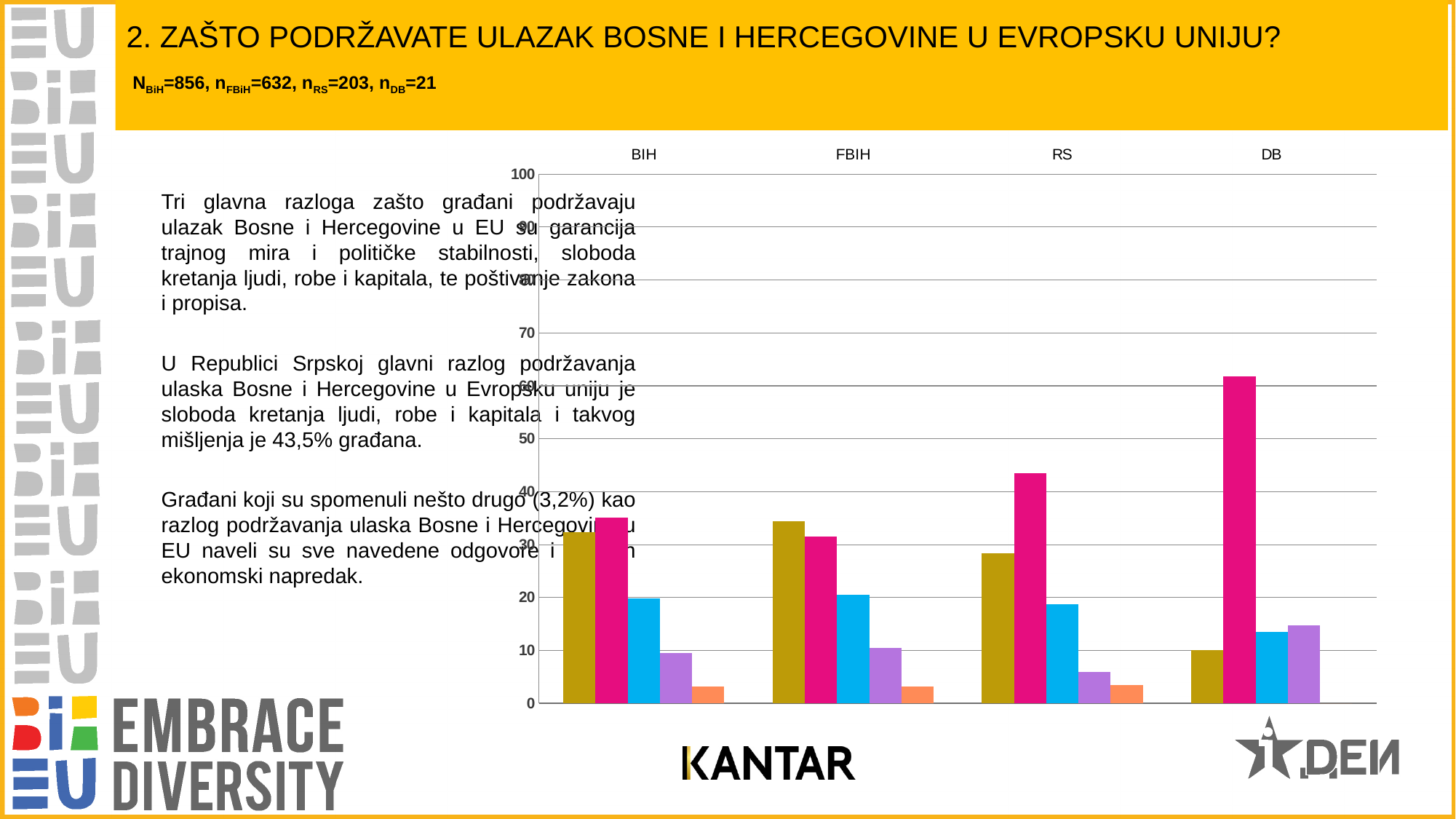
Is the value of the cyan bar for FBIH greater or less than 30? less What is the highest value shown on the y axis of the chart? 100 Is the value of the magenta bar for RS greater or less than 40? greater What kind of chart is shown on the slide? bar chart Which category has the lowest purple bar? RS In the DB group, which bar is larger, the magenta bar or the gold bar? magenta Is the value of the magenta bar for DB greater or less than 50? greater Which category has the lowest gold bar? DB Which category has the highest magenta bar? DB Which category has the tallest bar in the chart? DB How many categories are shown along the x axis of the chart? 4